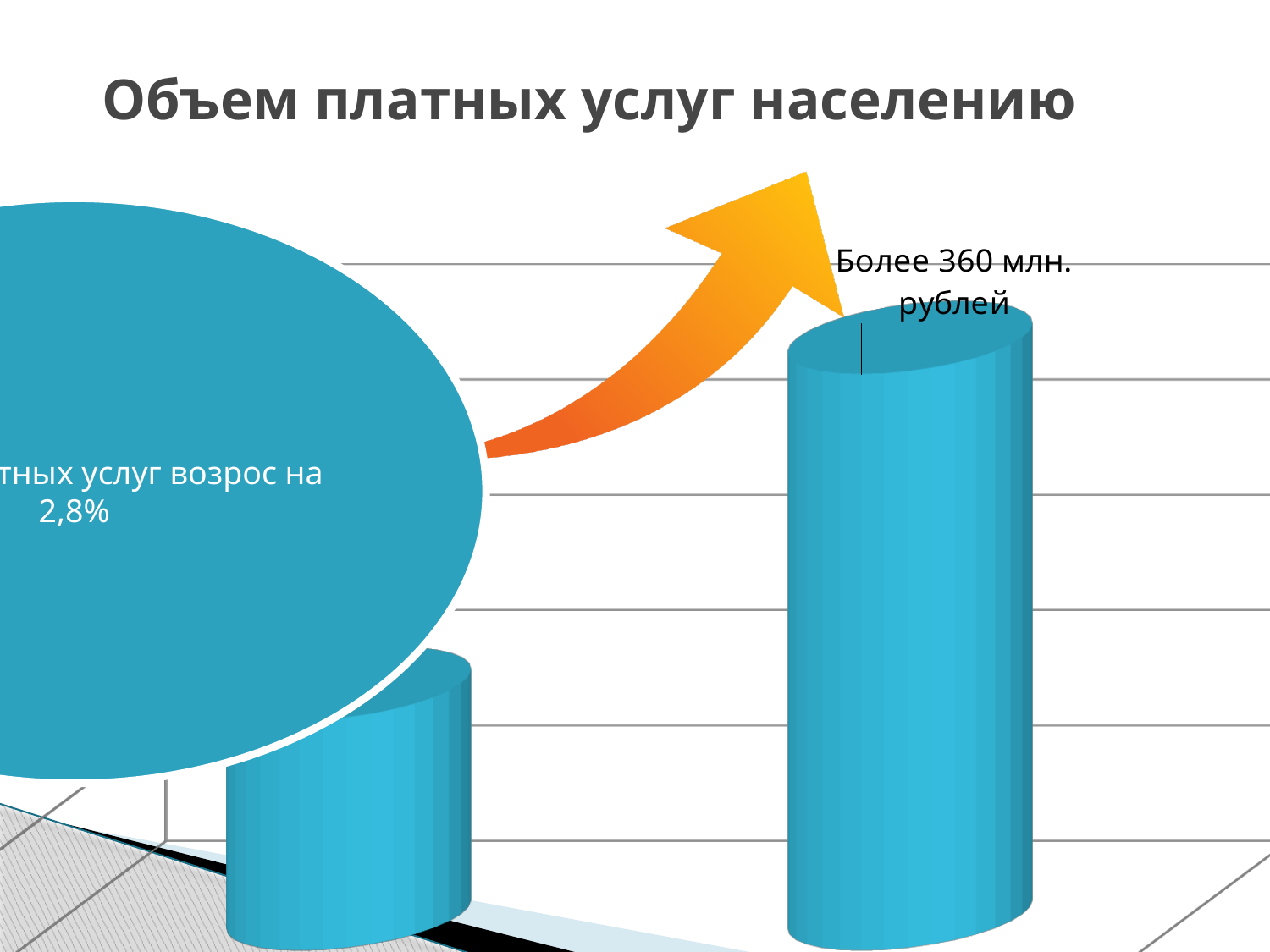
Which bar in the chart is the highest? the right bar By what percentage does the text on the slide say the volume of paid services grew? 2,8% What label is printed above the right bar? Более 360 млн. рублей What kind of chart is shown on the slide? bar chart What is the title of the chart on the slide? Объем платных услуг населению How many bars are plotted in the chart? 2 Do the bar values rise or fall from left to right? rise Which bar is taller, the left bar or the right bar? the right bar Which bar in the chart is the lowest? the left bar